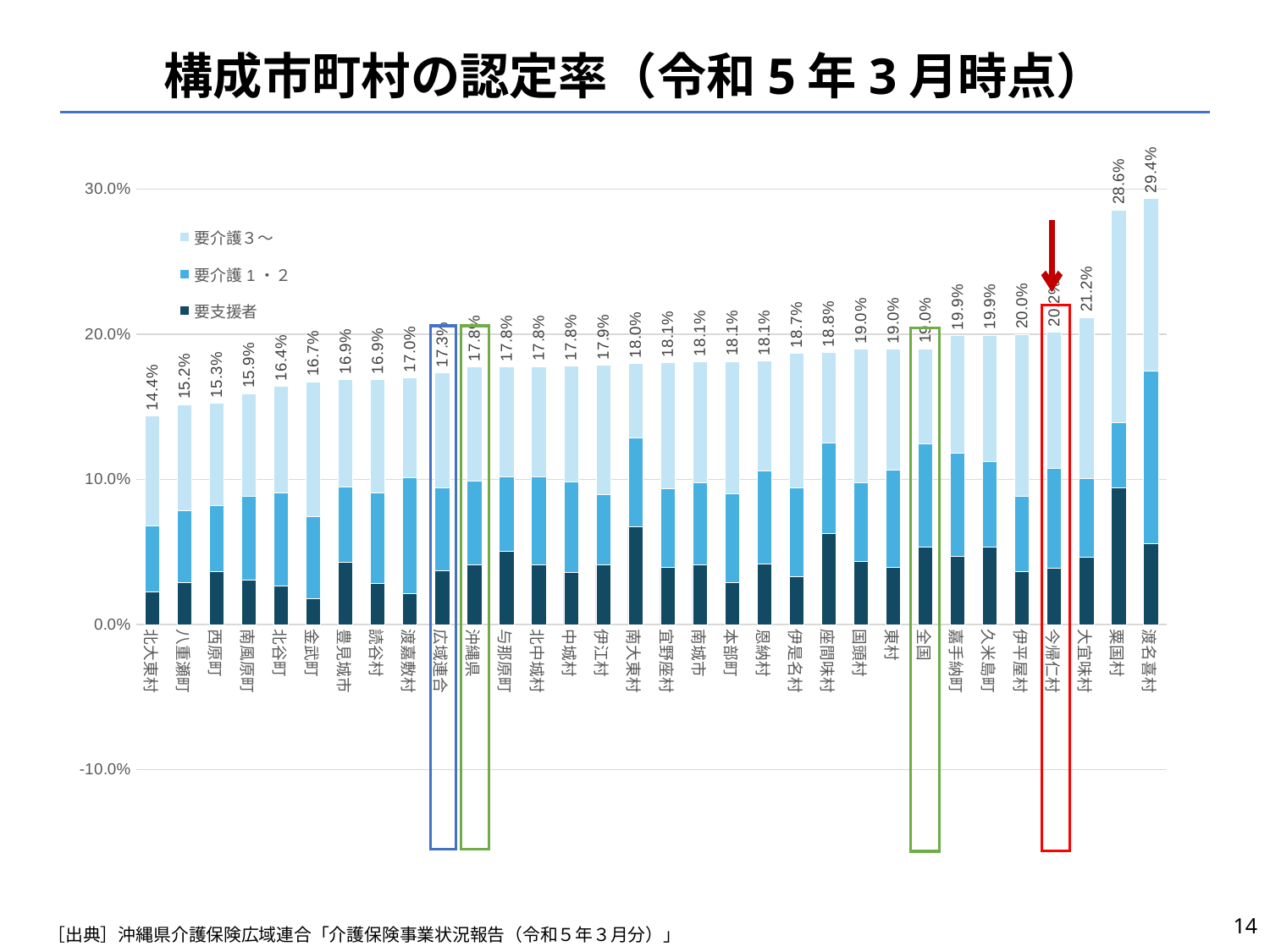
What is the total value labelled for 全国? 19.0% What kind of chart is shown on the slide? stacked bar chart What is the difference between the total rates of 渡名喜村 and 北大東村? 15.0% What is the total value labelled for 今帰仁村? 20.2% How many categories are plotted along the x axis? 32 What is the total certification rate shown for 渡名喜村? 29.4% Is the total value for 沖縄県 greater or less than 20.0%? less Do the total values rise or fall from left to right along the x axis? rise Which category has the highest total certification rate? 渡名喜村 Which category has the lowest total certification rate? 北大東村 How many series does the legend list? 3 Which has a higher total rate, 粟国村 or 大宜味村? 粟国村